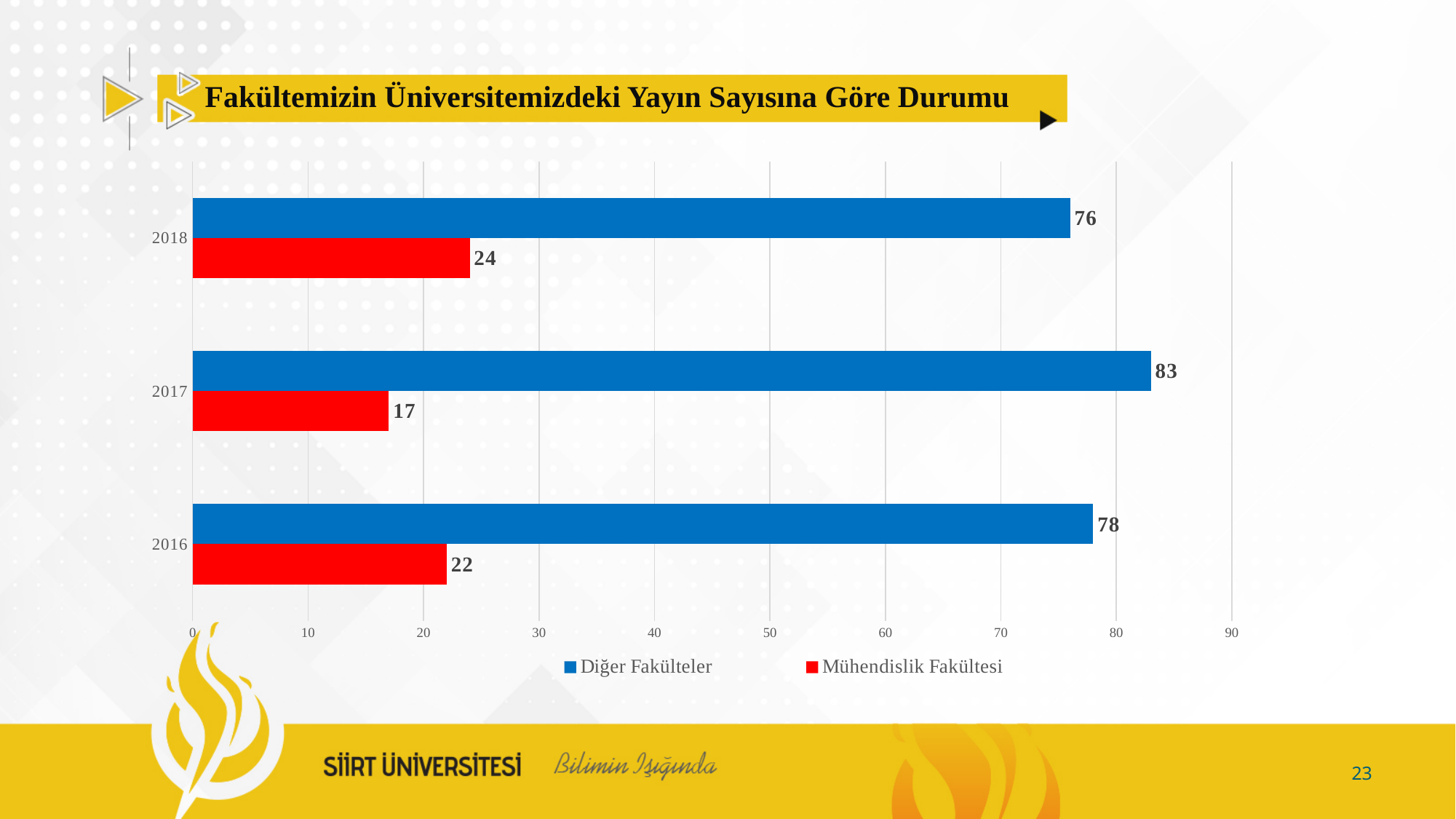
What kind of chart is shown on the slide? bar chart What is the value for Diğer Fakülteler in 2017? 83 In which year is the Mühendislik Fakültesi value lowest? 2017 How many series does the legend list? 2 Which is larger: Mühendislik Fakültesi in 2016 or in 2018? 2018 What is the value for Mühendislik Fakültesi in 2018? 24 In which year is the Diğer Fakülteler value highest? 2017 What is the difference between Diğer Fakülteler and Mühendislik Fakültesi in 2018? 52 What is the value for Mühendislik Fakültesi in 2016? 22 How many years are shown on the chart? 3 What colour are the Mühendislik Fakültesi bars? red Is the value for Diğer Fakülteler in 2016 greater or less than 70? greater